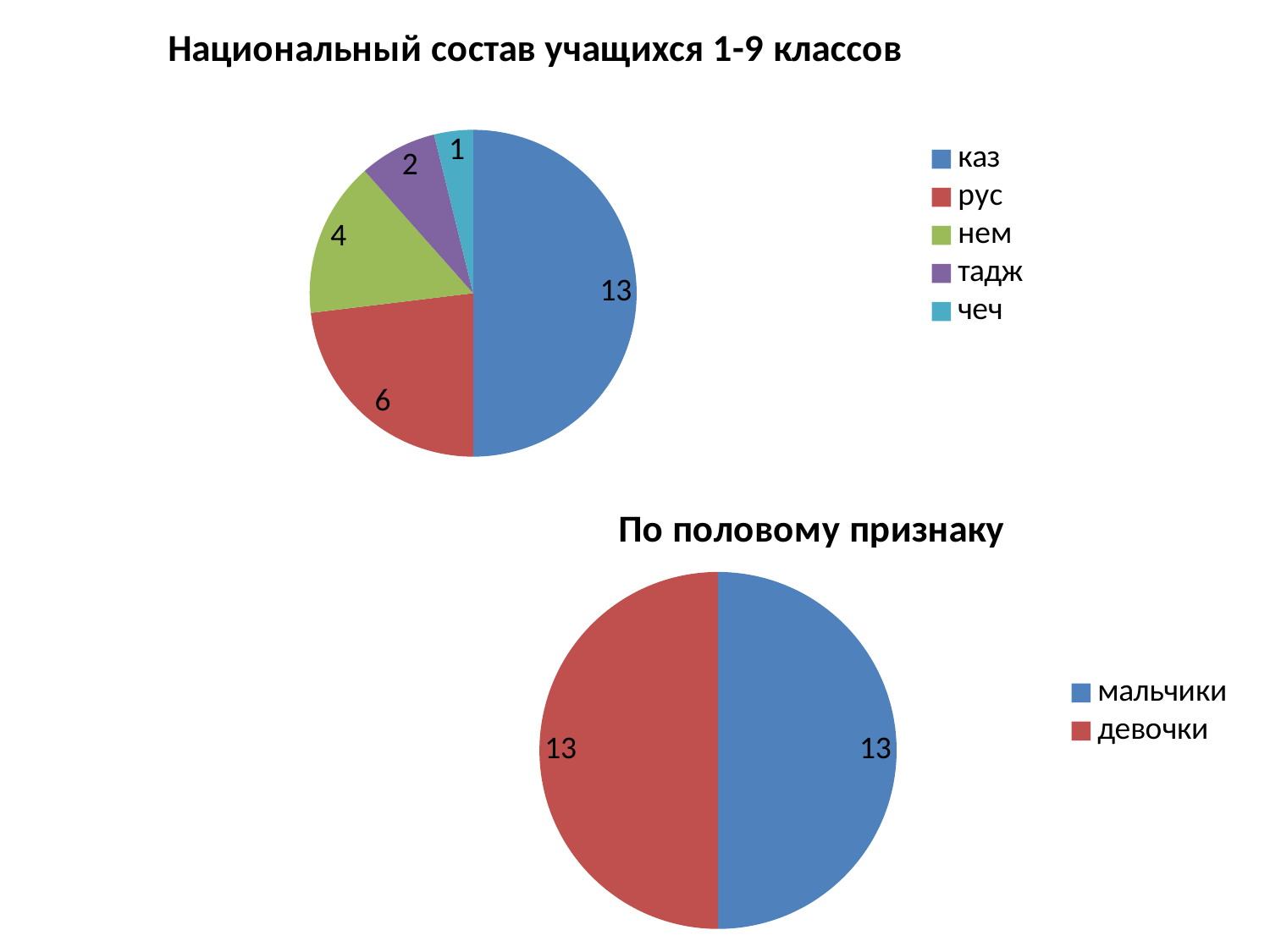
In the chart titled 'Национальный состав учащихся 1-9 классов', what is the difference between the values for рус and тадж? 4 In the chart titled 'По половому признаку', how many entries does the legend list? 2 In the chart titled 'Национальный состав учащихся 1-9 классов', how many categories are shown? 5 In the chart titled 'Национальный состав учащихся 1-9 классов', what share of the total does каз represent? 50% What kind of chart is the chart titled 'По половому признаку'? pie chart In the chart titled 'Национальный состав учащихся 1-9 классов', what is the value for нем? 4 In the chart titled 'По половому признаку', what colour is the slice for мальчики? blue In the chart titled 'По половому признаку', what is the value for девочки? 13 In the chart titled 'Национальный состав учащихся 1-9 классов', which is larger, рус or нем? рус In the chart titled 'Национальный состав учащихся 1-9 классов', what is the value for каз? 13 In the chart titled 'Национальный состав учащихся 1-9 классов', which category has the smallest slice? чеч In the chart titled 'Национальный состав учащихся 1-9 классов', which category has the largest slice? каз